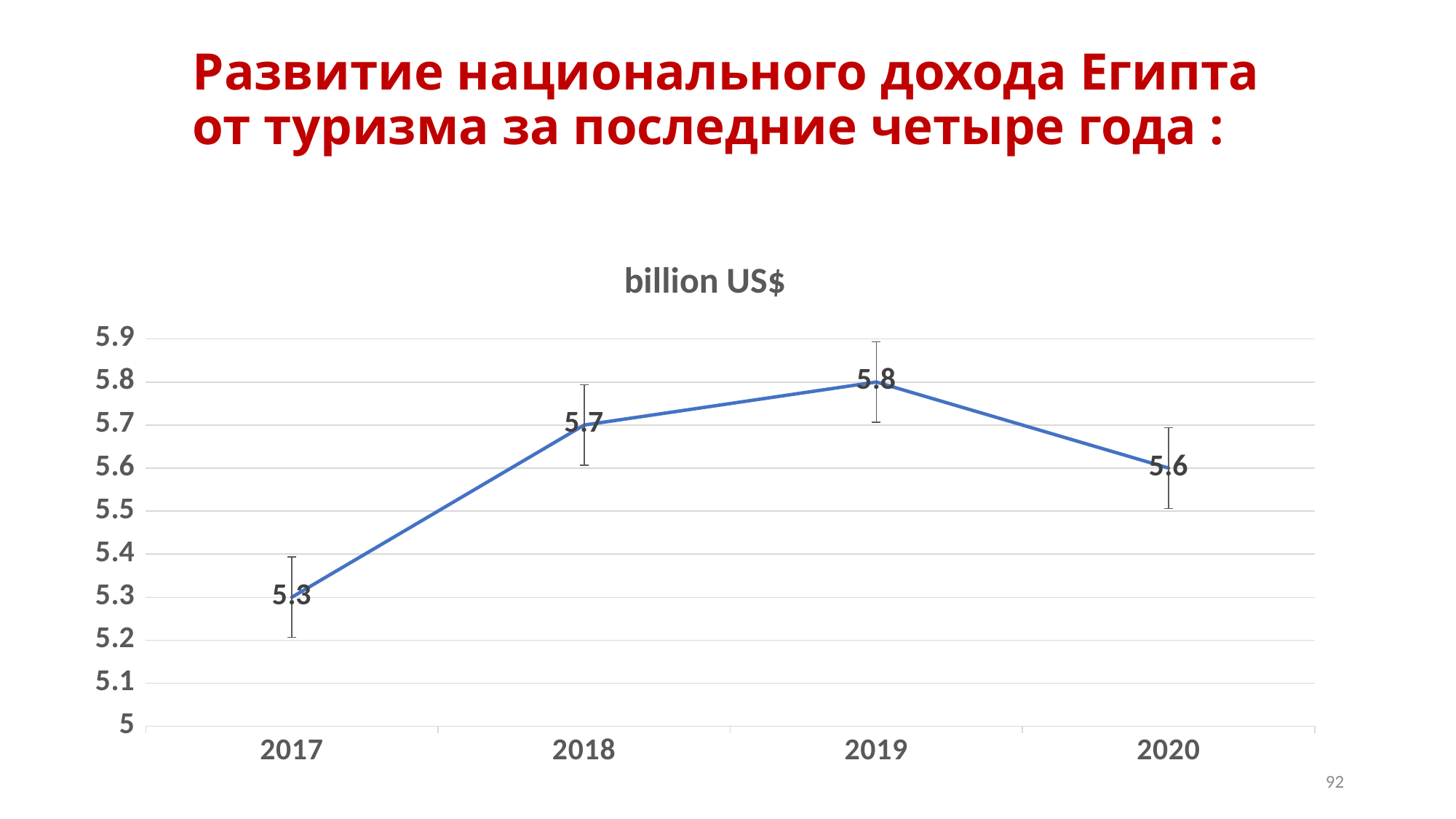
What is the value for 2019? 5.8 Which year has the lowest value? 2017 What is the difference between the values for 2019 and 2017? 0.5 How many years are plotted on the chart? 4 Which is larger, the value for 2018 or the value for 2020? 2018 What is the value for 2018? 5.7 What is the title of the chart? billion US$ What is the value for 2017? 5.3 Which year has the highest value? 2019 Does the value rise or fall from 2019 to 2020? fall What kind of chart is shown on the slide? line chart What is the value for 2020? 5.6